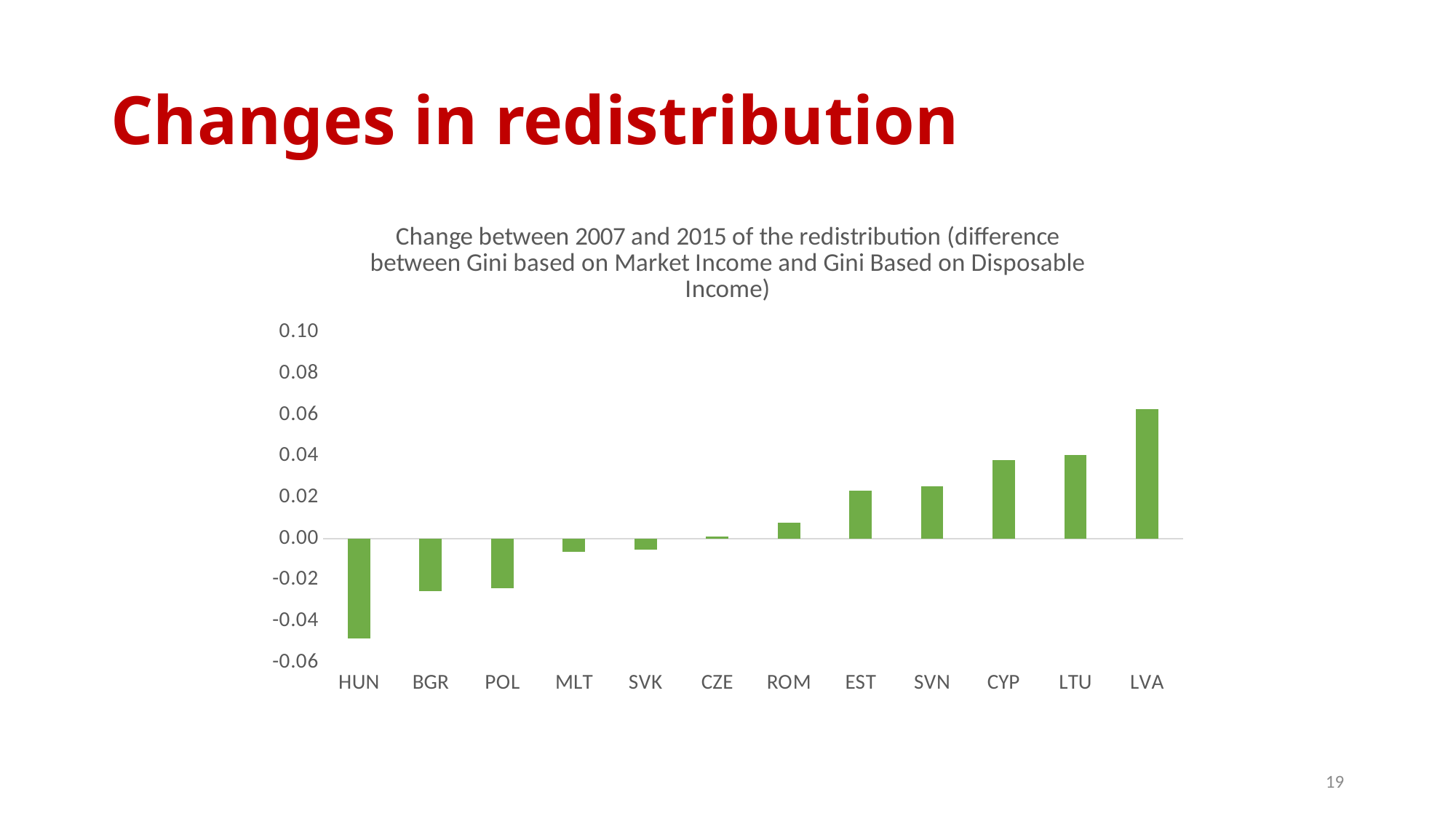
Which has the larger value, CYP or EST? CYP Which country has the lowest value in the chart? HUN What kind of chart is shown on the slide? bar chart What colour are the bars in the chart? green Which country has the highest value in the chart? LVA Is the value for LVA greater or less than 0.04? greater Do the values generally rise or fall moving from left to right along the x axis? rise Is the value for CYP greater or less than 0.02? greater Is the value for HUN greater or less than -0.04? less How many countries are shown on the x axis of the chart? 12 Which has the larger value, LVA or LTU? LVA